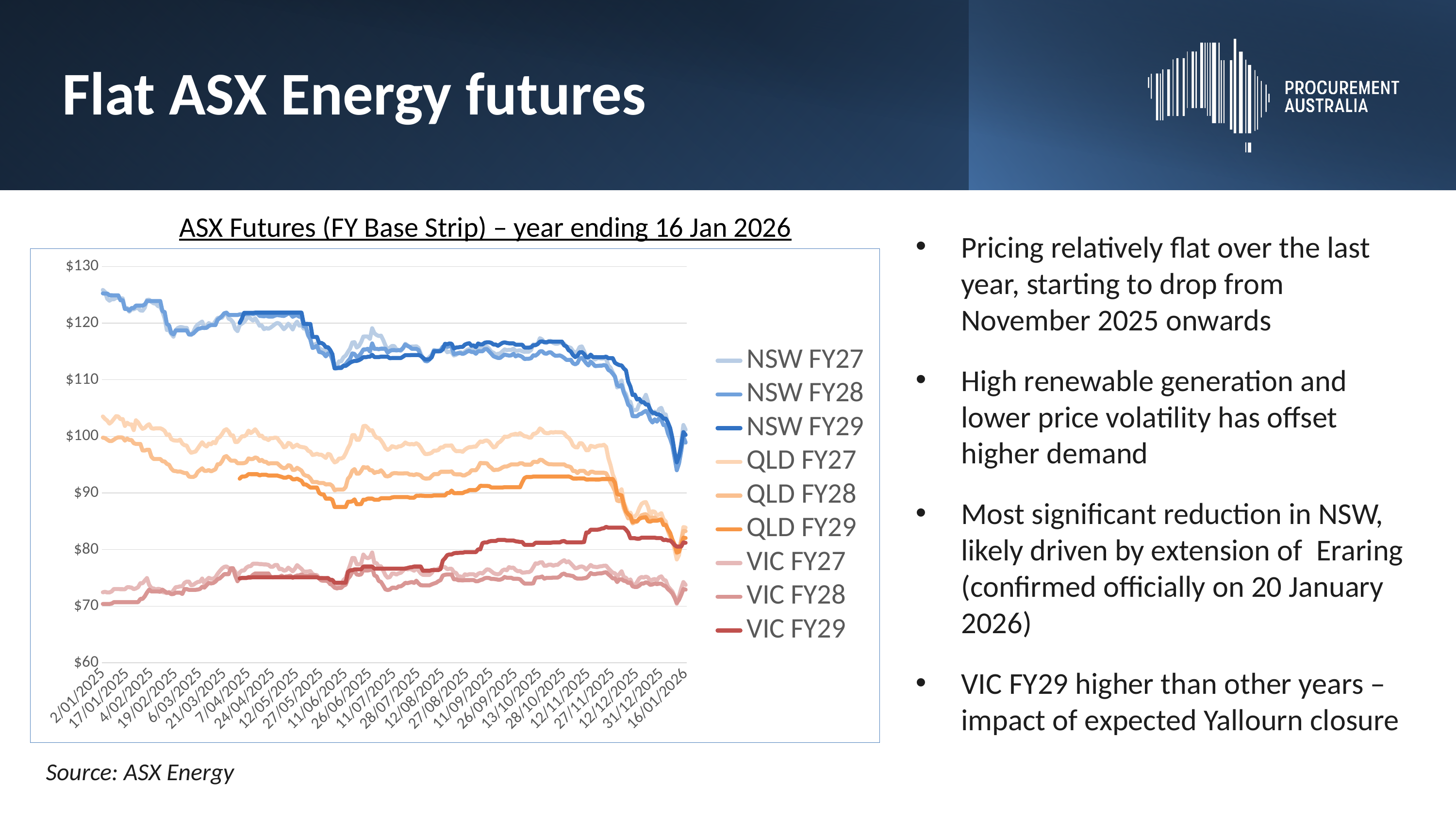
Is the value for NSW FY27 at the start of the period (2/01/2025) greater or less than $120? greater Which state's futures series sit lowest on the chart across the whole period? VIC Do the NSW futures series rise or fall between November 2025 and January 2026? fall What is the title of the chart? ASX Futures (FY Base Strip) – year ending 16 Jan 2026 What kind of chart is shown on the slide? line chart Which is higher at the end of the period, VIC FY29 or VIC FY27? VIC FY29 Which state's futures series sit highest on the chart across the whole period? NSW What is the source cited for the chart data? ASX Energy Is the value for VIC FY28 at the start of the period (2/01/2025) greater or less than $80? less Is the value for NSW FY29 at the end of the period (16/01/2026) greater or less than $110? less How many series does the chart legend list? 9